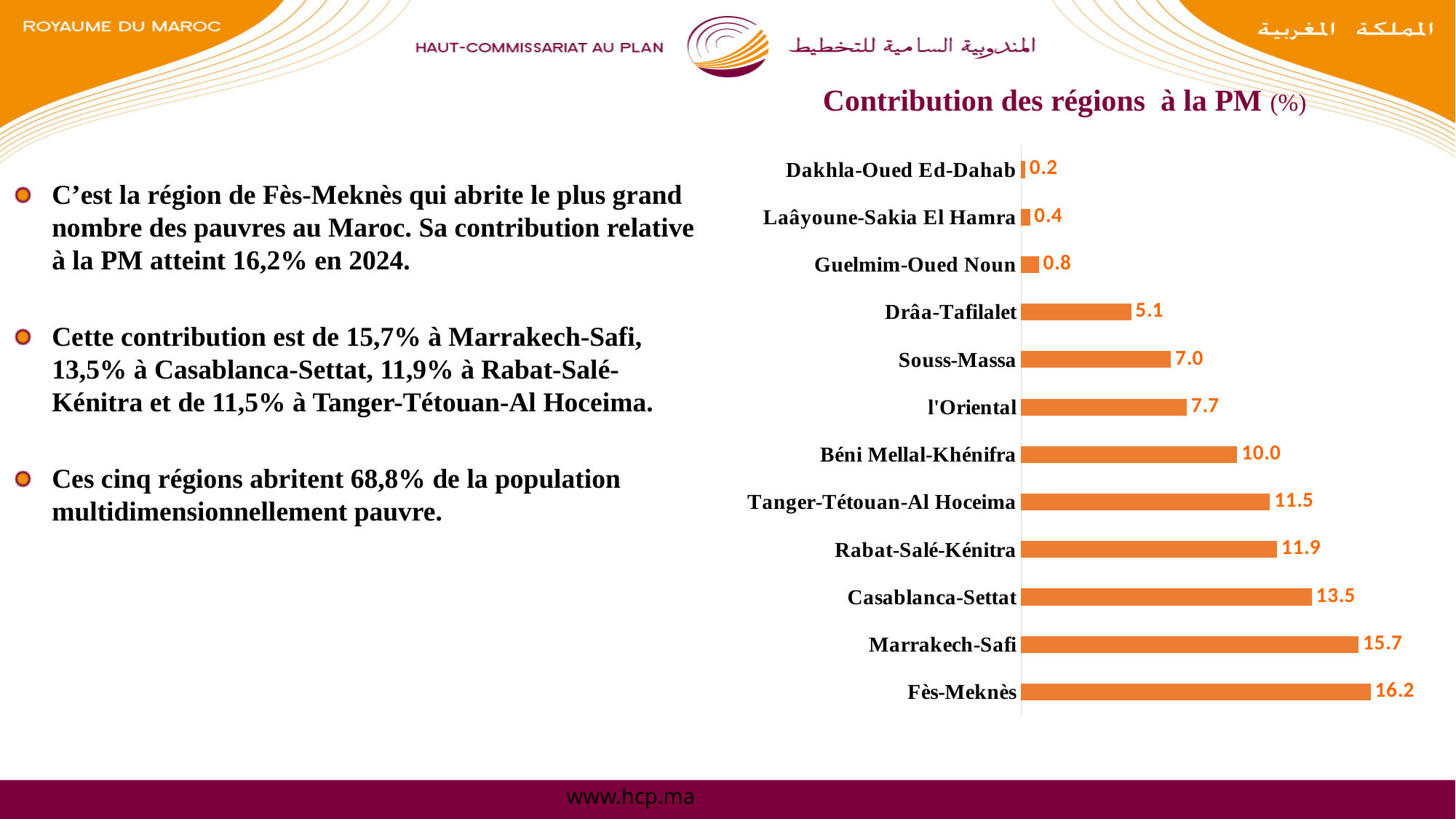
What colour are the bars in the chart? Orange What is the value for Fès-Meknès in the chart? 16.2 What is the difference between the values for Casablanca-Settat and Rabat-Salé-Kénitra? 1.6 What is the value for Guelmim-Oued Noun in the chart? 0.8 How many regions are shown in the chart? 12 What is the value for Souss-Massa in the chart? 7.0 Which region has the highest contribution in the chart? Fès-Meknès Which has a larger value, Béni Mellal-Khénifra or l'Oriental? Béni Mellal-Khénifra What is the difference between the values for Marrakech-Safi and Tanger-Tétouan-Al Hoceima? 4.2 What is the title of the chart? Contribution des régions à la PM (%) Which region has the lowest contribution in the chart? Dakhla-Oued Ed-Dahab What kind of chart is shown on the slide? Bar chart